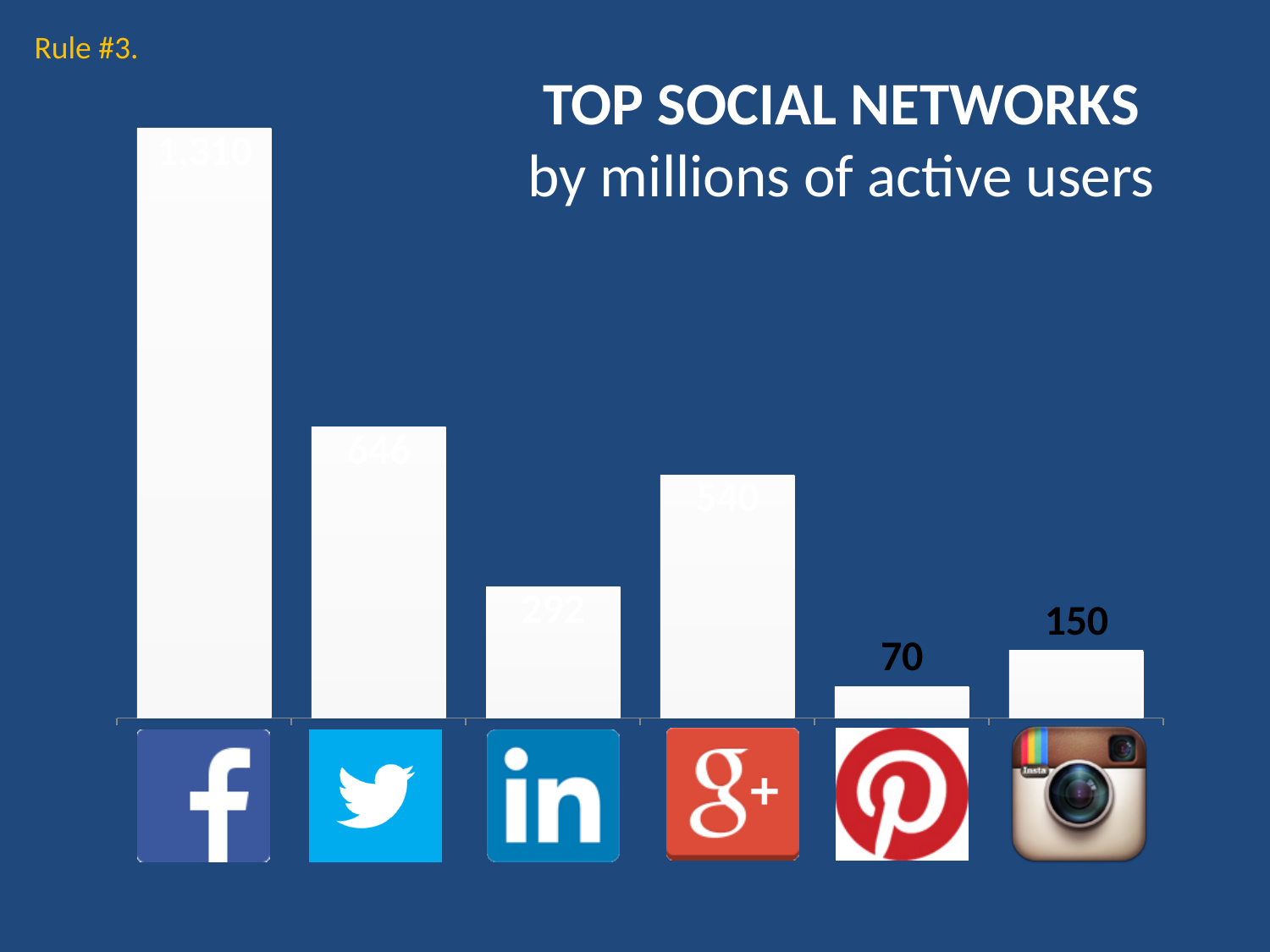
What is the value shown for Pinterest? 70 What is the value shown for Instagram? 150 Which has the larger value, Twitter or Google+? Twitter What kind of chart is shown on the slide? bar chart In what unit are the values in the chart expressed? millions of active users Which social network has the lowest bar in the chart? Pinterest How many social networks (bars) are shown in the chart? 6 Which has the larger value, LinkedIn or Instagram? LinkedIn What is the title of the chart? TOP SOCIAL NETWORKS by millions of active users What is the difference between the values for Instagram and Pinterest? 80 Which has the larger value, Google+ or LinkedIn? Google+ Which social network has the highest bar in the chart? Facebook